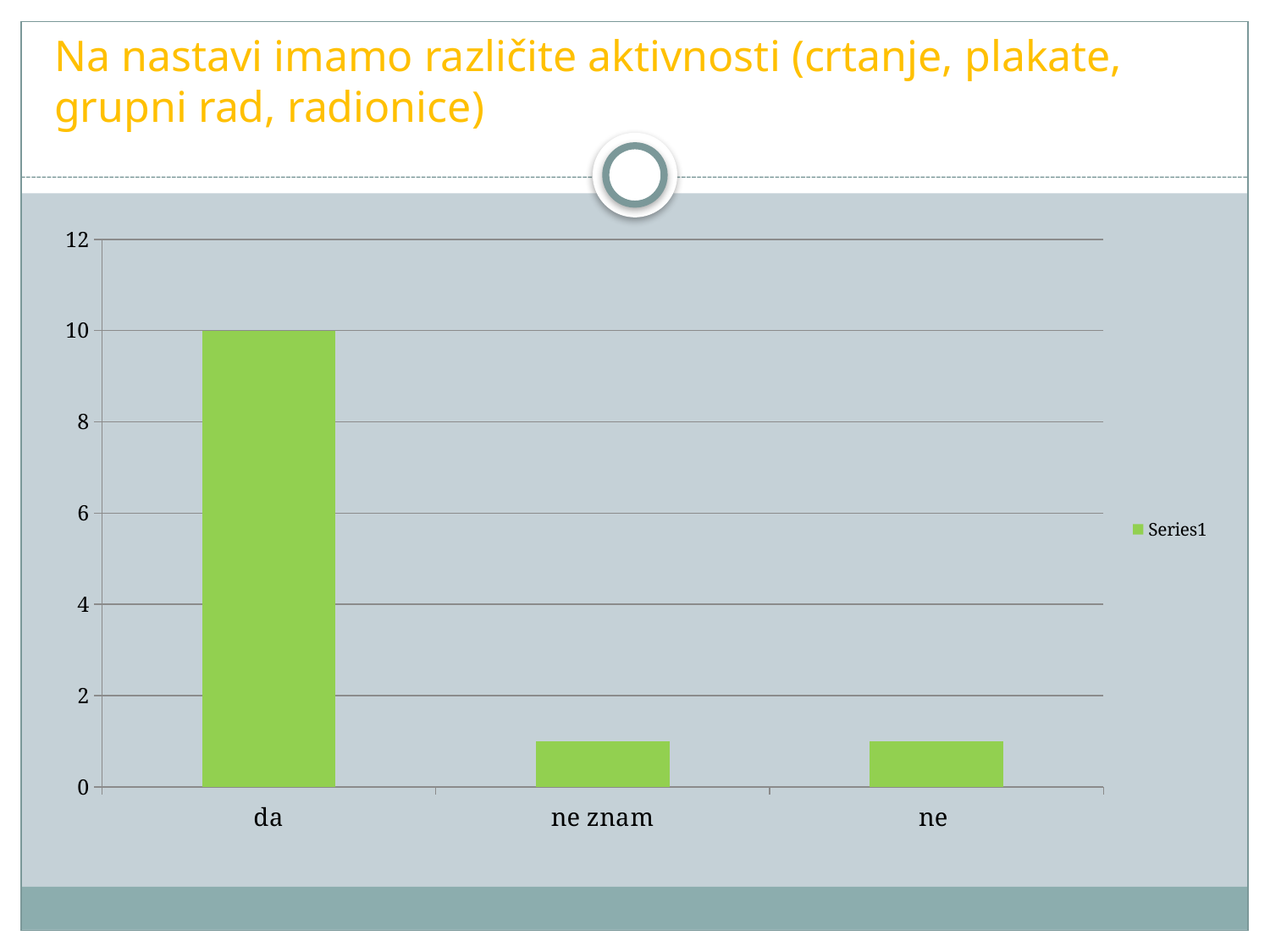
Is the value for "ne znam" greater or less than 2? less Which category has the highest value? da Is the value for "ne" greater or less than 2? less What is the name of the series shown in the legend? Series1 How many series does the legend list? 1 How many categories are shown on the x axis? 3 What kind of chart is shown on the slide? bar chart What is the highest value shown on the vertical axis? 12 What is the value for "da"? 10 Is the value for "da" greater or less than 8? greater Which is larger, the value for "da" or the value for "ne znam"? da Which is larger, the value for "da" or the value for "ne"? da